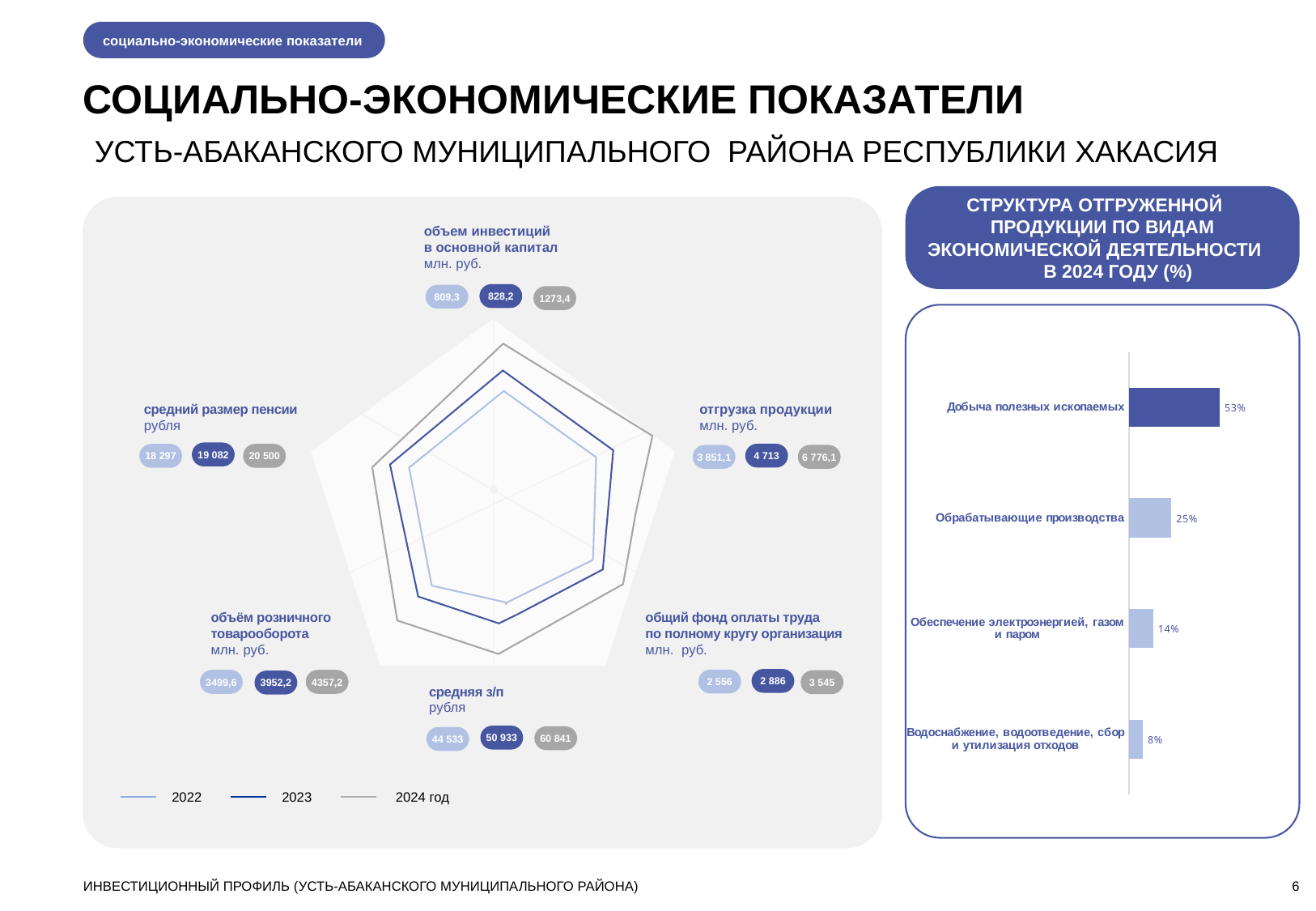
На диаграмме «Структура отгруженной продукции по видам экономической деятельности в 2024 году» какая доля у категории «Добыча полезных ископаемых»? 53% На лепестковой диаграмме слева что больше: отгрузка продукции в 2023 году или в 2024 году? 2024 год (6 776,1) На лепестковой диаграмме слева какой год показан серой линией? 2024 На лепестковой диаграмме слева каков объем инвестиций в основной капитал за 2024 год? 1273,4 Сколько категорий показано на диаграмме «Структура отгруженной продукции по видам экономической деятельности в 2024 году»? 4 На лепестковой диаграмме слева как меняется средний размер пенсии с 2022 по 2024 год? Растёт На лепестковой диаграмме слева какова средняя з/п за 2023 год? 50 933 На лепестковой диаграмме слева на сколько вырос общий фонд оплаты труда с 2022 по 2024 год? 989 На лепестковой диаграмме слева сколько серий (годов) указано в легенде? 3 Какого типа диаграмма «Структура отгруженной продукции по видам экономической деятельности в 2024 году»? Столбчатая (bar chart) На диаграмме «Структура отгруженной продукции» на сколько процентных пунктов доля обрабатывающих производств больше доли обеспечения электроэнергией, газом и паром? 11 На диаграмме «Структура отгруженной продукции» какая категория имеет наименьшую долю? Водоснабжение, водоотведение, сбор и утилизация отходов